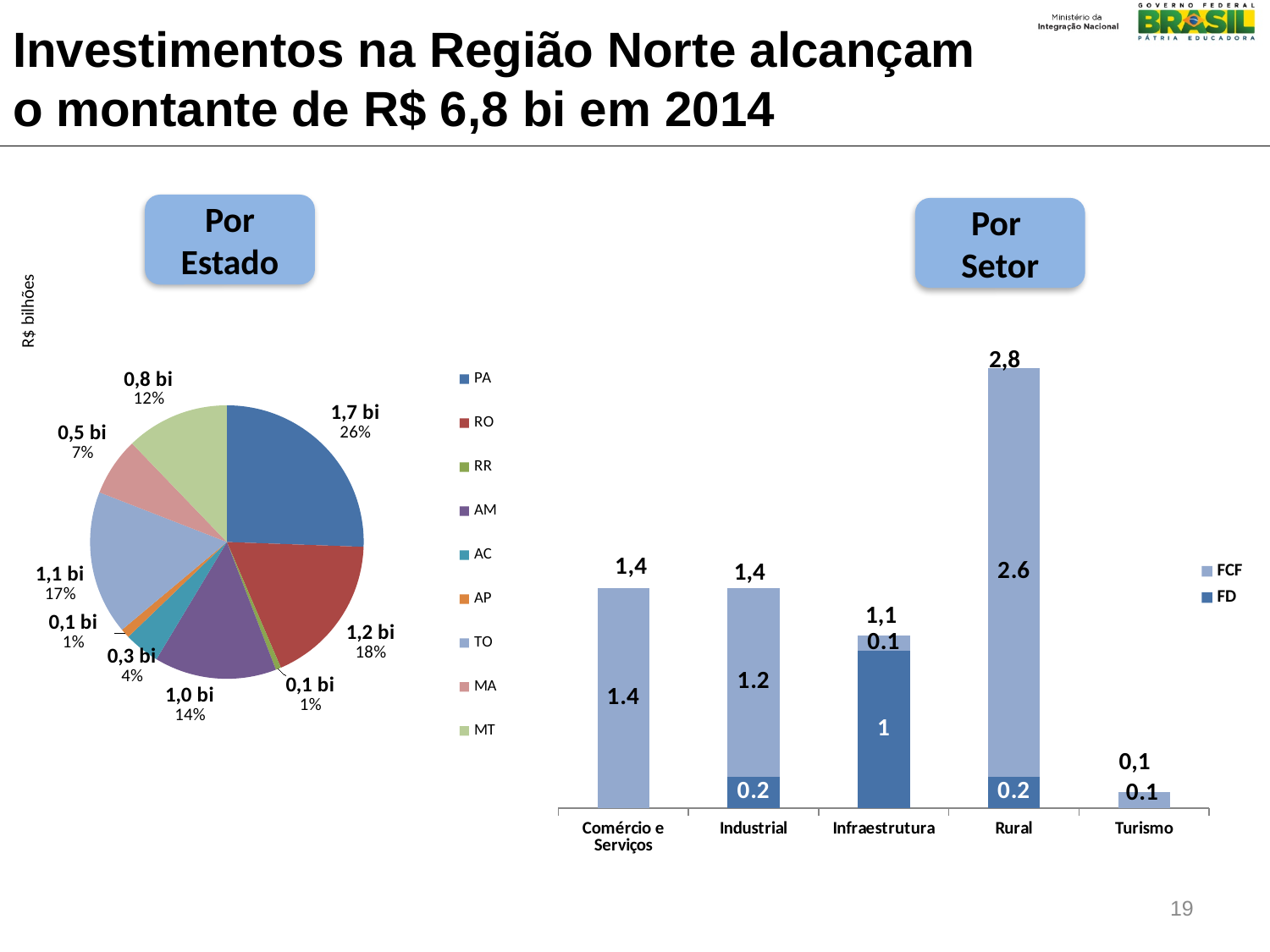
In the 'Por Setor' chart, which sector has the lowest total? Turismo In the 'Por Setor' chart, how many series does the legend list? 2 In the 'Por Estado' pie chart, what value is shown for MT? 0,8 bi In the 'Por Estado' pie chart, how many states are listed in the legend? 9 In the 'Por Setor' chart, what is the difference between the FCF values for Rural and Industrial? 1.4 In the 'Por Setor' chart, what is the FD value for Infraestrutura? 1 In the 'Por Estado' pie chart, which state has the largest slice? PA In the 'Por Estado' pie chart, which is larger, the slice for RO or the slice for AM? RO In the 'Por Setor' chart, what is the total value of the Rural bar? 2,8 In the 'Por Estado' pie chart, what share of the total does TO represent? 17% In the 'Por Estado' pie chart, what value and share are shown for PA? 1,7 bi, 26% What type of chart is the 'Por Setor' chart? Stacked bar chart